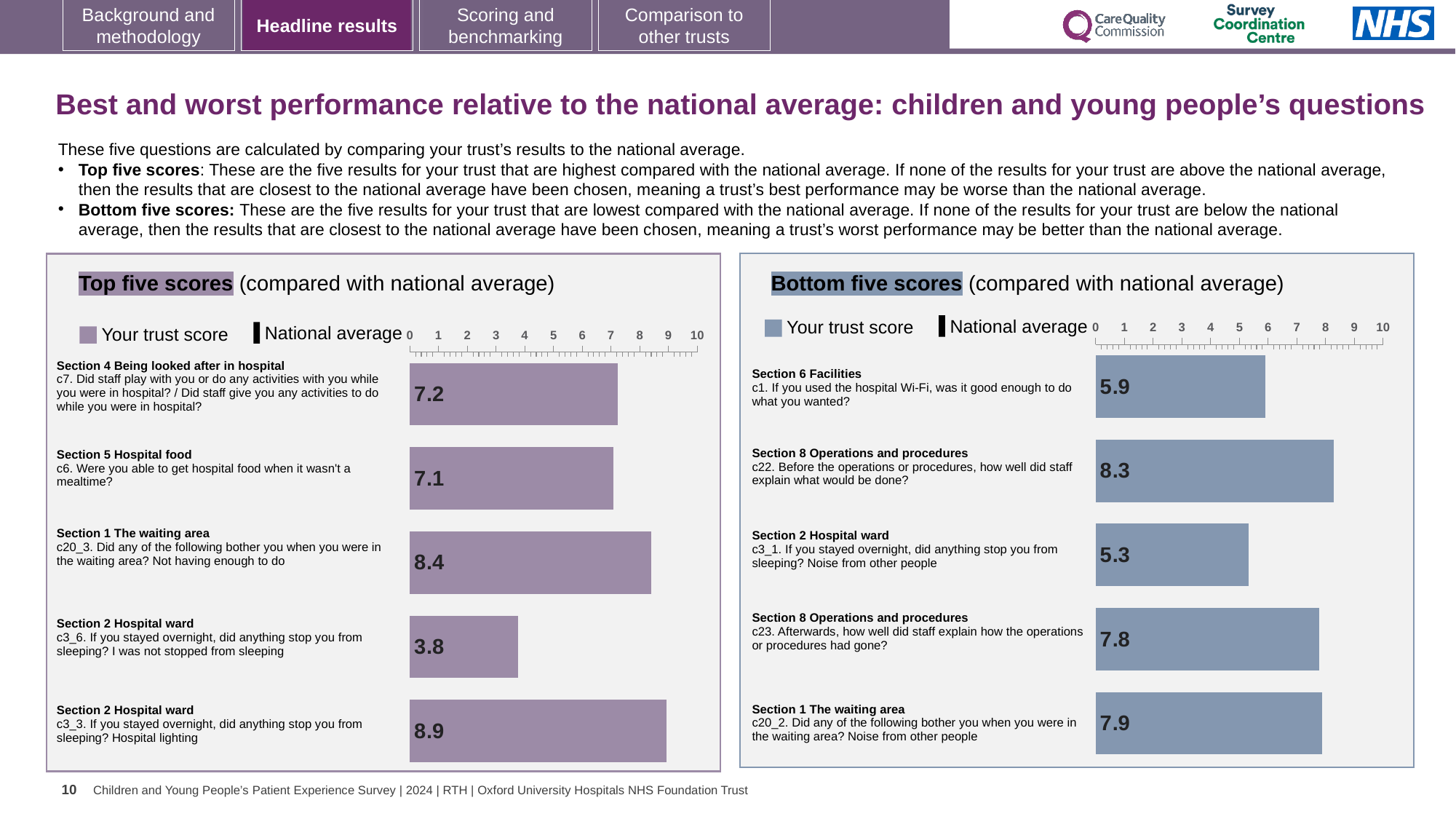
In the Top five scores chart, what is the trust score for c7 (Did staff play with you or do any activities with you while you were in hospital?)? 7.2 In the Top five scores chart, which question has the highest trust score? c3_3. Hospital lighting How many questions are shown in the Bottom five scores chart? 5 In the Top five scores chart, what is the trust score for c3_6 (I was not stopped from sleeping)? 3.8 What kind of chart is the Top five scores chart? Bar chart In the Bottom five scores chart, which question has the lowest trust score? c3_1. Noise from other people In the Bottom five scores chart, what is the trust score for c1 (hospital Wi-Fi)? 5.9 In the Top five scores chart, what is the difference between the trust scores for c3_3 (8.9) and c20_3 (8.4)? 0.5 In the Bottom five scores chart, which has the larger trust score: c1 (Wi-Fi) or c3_1 (Noise from other people)? c1 (Wi-Fi) In the Bottom five scores chart, which question has the highest trust score? c22. Before the operations or procedures, how well did staff explain what would be done? In the Bottom five scores chart, what is the trust score for c23 (how well did staff explain how the operations or procedures had gone)? 7.8 In the Top five scores chart, which question has the lowest trust score? c3_6. I was not stopped from sleeping